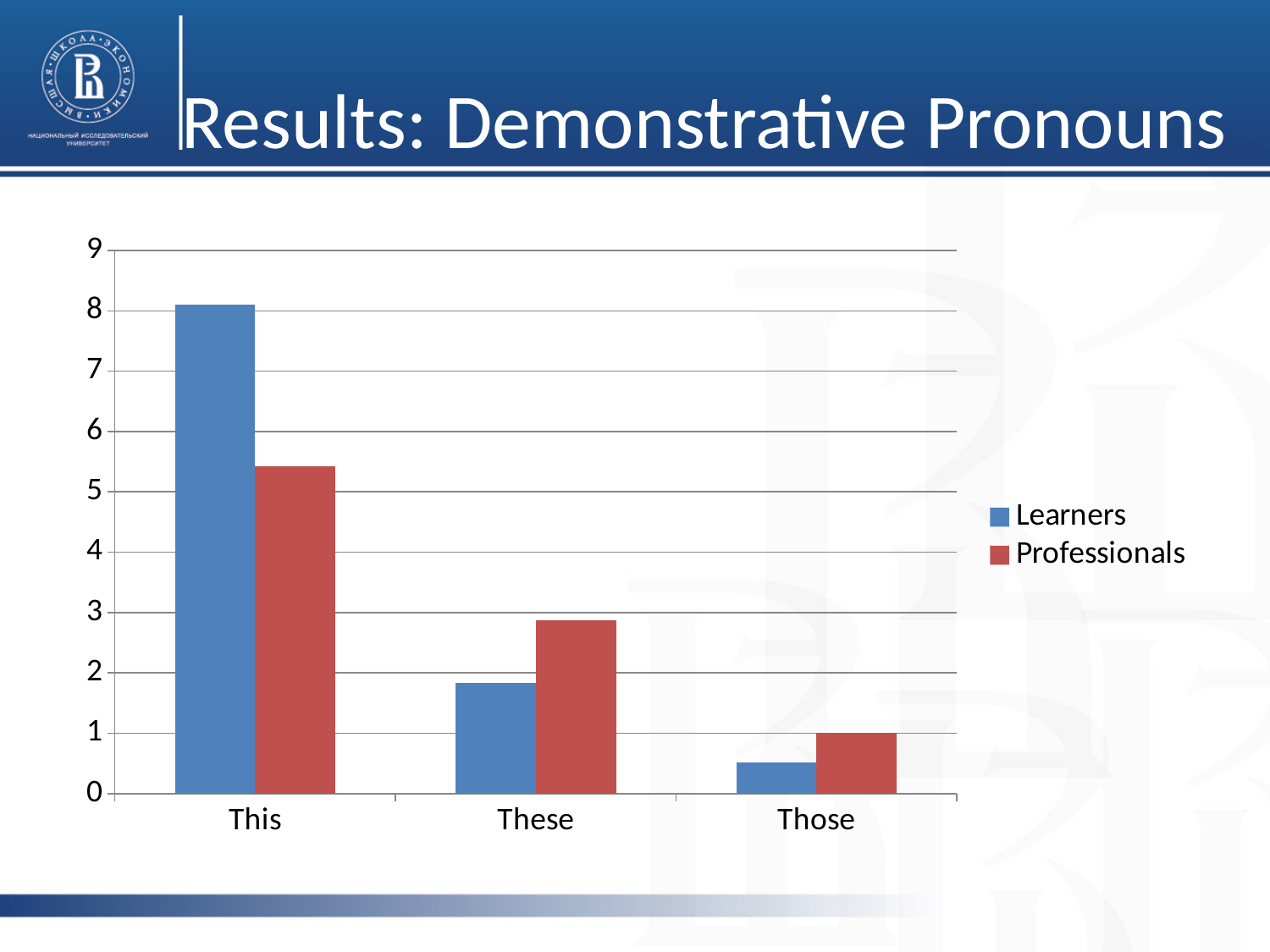
For the category These, which series has the larger value, Learners or Professionals? Professionals Which category has the highest value for Learners? This For the category This, which series has the larger value, Learners or Professionals? Learners What is the title of the slide containing the chart? Results: Demonstrative Pronouns Is the value for Learners in the category This greater or less than 8? greater What kind of chart is shown on the slide? bar chart Which category has the highest value for Professionals? This Is the value for Professionals in the category These greater or less than 3? less How many categories are shown on the x axis? 3 How many series does the legend list? 2 Which category has the lowest value for Professionals? Those Which category has the lowest value for Learners? Those